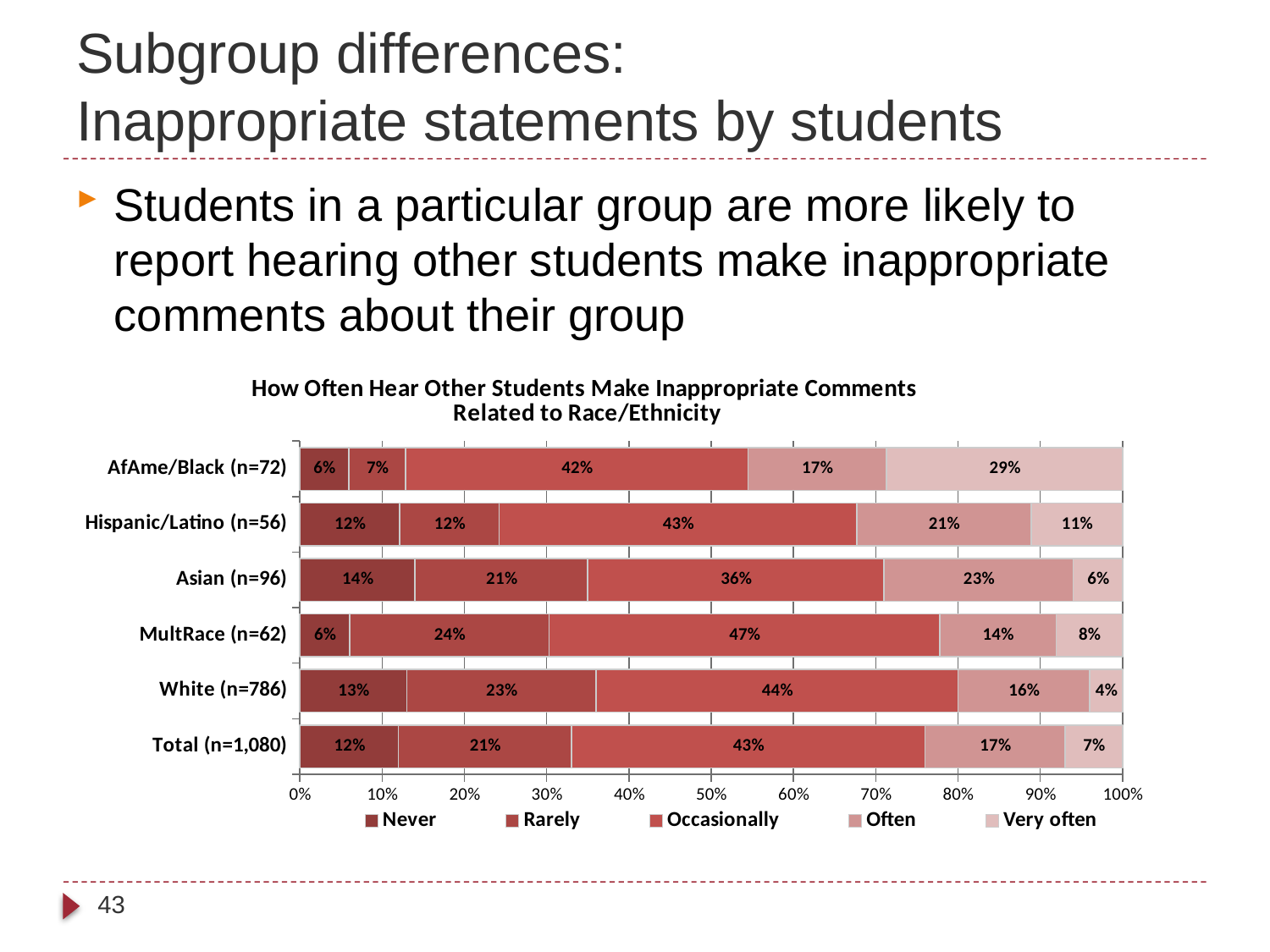
What is the "Never" value for White (n=786)? 13% Which is larger: the "Rarely" value for MultRace (n=62) or the "Rarely" value for Asian (n=96)? MultRace (n=62) What is the "Occasionally" value for MultRace (n=62)? 47% How many groups (categories) are shown on the chart? 6 What is the difference between the "Very often" values for AfAme/Black (n=72) and Hispanic/Latino (n=56)? 18 percentage points What kind of chart is shown on the slide? Stacked bar chart Which group has the highest "Very often" percentage? AfAme/Black (n=72) Which group has the lowest "Very often" percentage? White (n=786) How many series does the legend list? 5 What is the title of the chart? How Often Hear Other Students Make Inappropriate Comments Related to Race/Ethnicity What is the "Often" value for Asian (n=96)? 23% What percentage of AfAme/Black (n=72) students report hearing inappropriate comments "Very often"? 29%